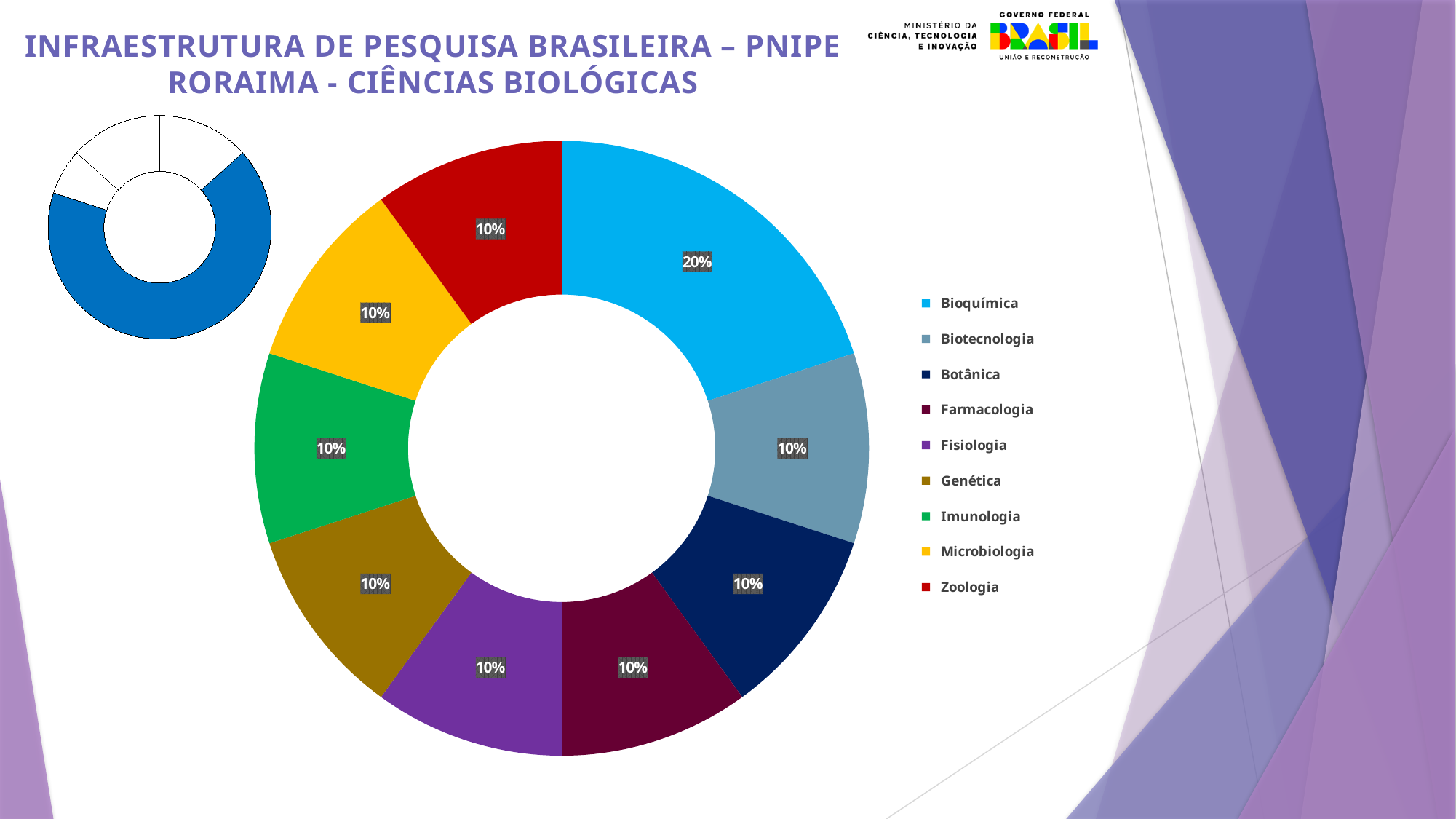
In the large donut chart, what share does Bioquímica have? 20% What kind of chart is the large chart in the centre of the slide? Donut (pie) chart In the large donut chart, which category is shown in red? Zoologia In the large donut chart, what is the difference between the shares of Bioquímica and Biotecnologia? 10% In the large donut chart, what share does Microbiologia have? 10% In the large donut chart, which category is shown in green? Imunologia In the large donut chart, what share does Zoologia have? 10% In the large donut chart, what share does Genética have? 10% In the large donut chart, which is larger, the share of Bioquímica or the share of Fisiologia? Bioquímica How many categories does the legend of the large donut chart list? 9 In the large donut chart, what is the combined share of Imunologia and Microbiologia? 20% In the large donut chart, which category has the largest share? Bioquímica